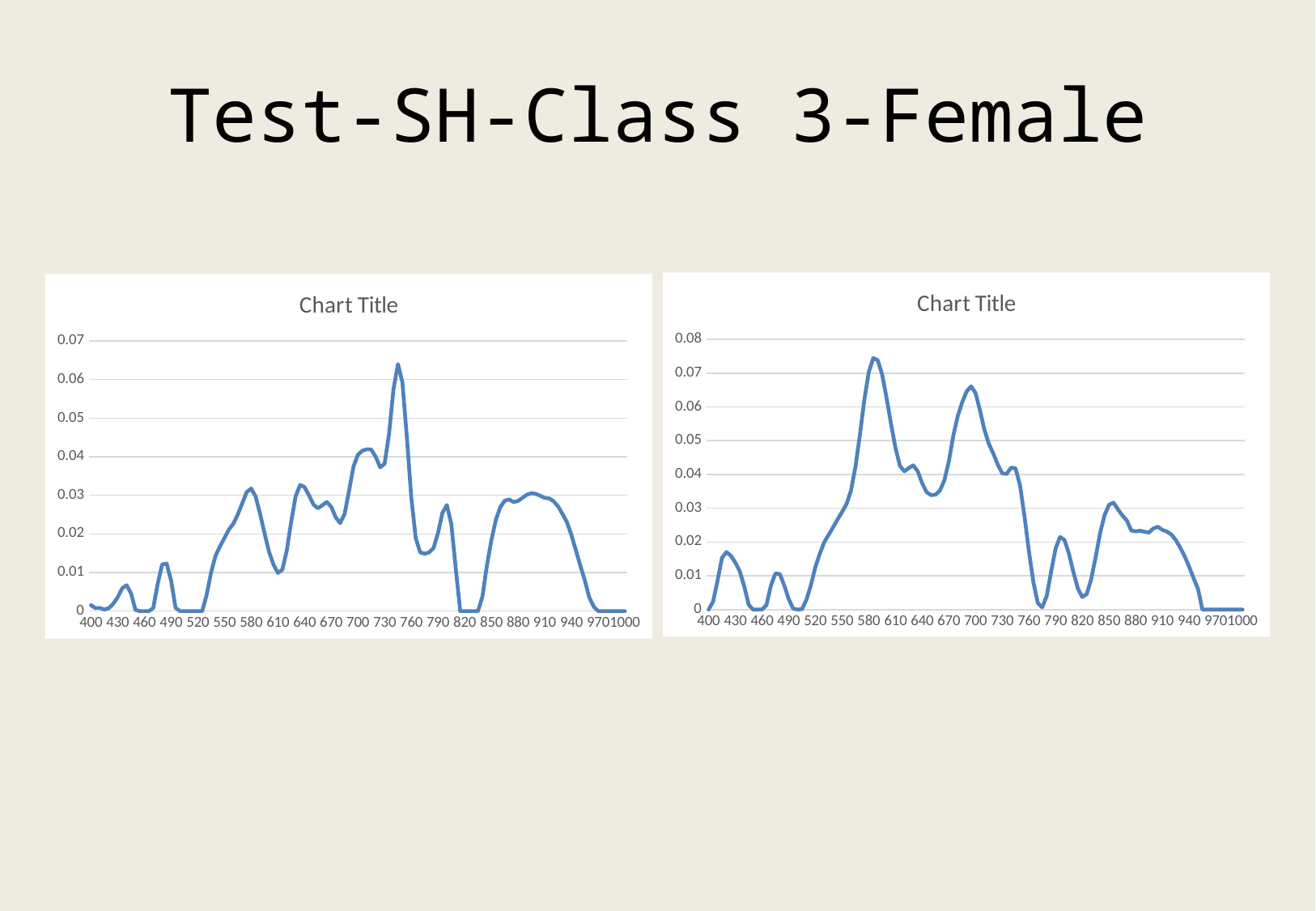
What is the title shown above the chart on the left? Chart Title In the chart on the left, is the value at 580 greater or less than 0.02? greater What kind of chart is the chart on the left of the slide? line chart In the chart on the right, is the value at 1000 greater or less than 0.01? less In the chart on the right, does the line rise or fall between 940 and 1000? fall In the chart on the right, is the highest point of the line greater or less than 0.07? greater Which chart reaches a higher peak value, the one on the left or the one on the right? the one on the right What is the highest value labelled on the vertical axis of the chart on the right? 0.08 What kind of chart is the chart on the right of the slide? line chart